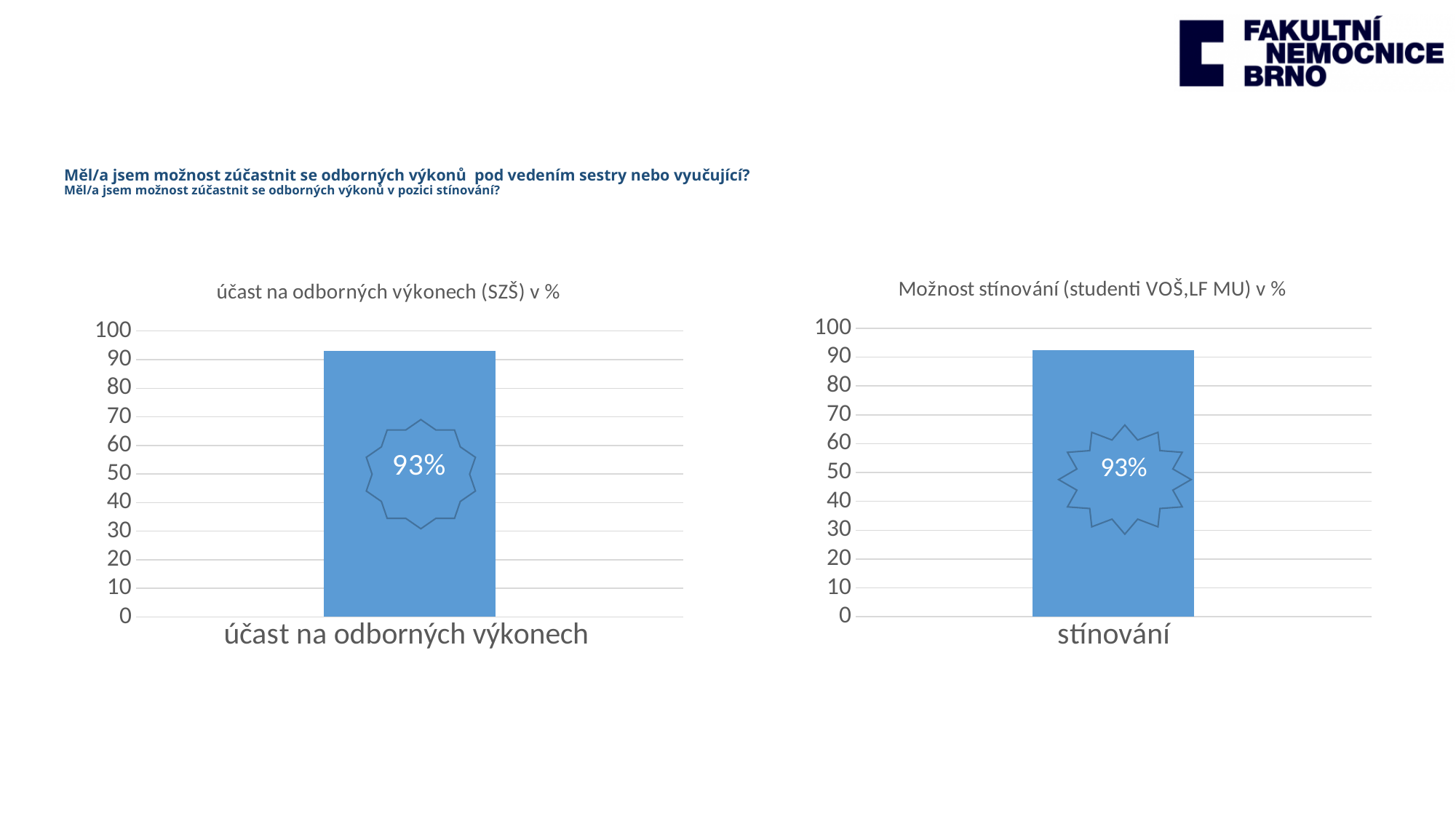
What is the difference between the value in the left chart ('účast na odborných výkonech') and the value in the right chart ('stínování')? 0 In the left chart titled 'účast na odborných výkonech (SZŠ) v %', is the value for 'účast na odborných výkonech' greater or less than 90? greater How many bars are plotted in the right chart titled 'Možnost stínování (studenti VOŠ,LF MU) v %'? 1 In the left chart titled 'účast na odborných výkonech (SZŠ) v %', what is the value for 'účast na odborných výkonech'? 93% What kind of chart is the left chart titled 'účast na odborných výkonech (SZŠ) v %'? bar chart How many bars are plotted in the left chart titled 'účast na odborných výkonech (SZŠ) v %'? 1 What kind of chart is the right chart titled 'Možnost stínování (studenti VOŠ,LF MU) v %'? bar chart In the right chart titled 'Možnost stínování (studenti VOŠ,LF MU) v %', what is the value for 'stínování'? 93% In the right chart titled 'Možnost stínování (studenti VOŠ,LF MU) v %', is the value for 'stínování' greater or less than 100? less What is the title of the left chart? účast na odborných výkonech (SZŠ) v % What is the maximum value shown on the y axis of the left chart titled 'účast na odborných výkonech (SZŠ) v %'? 100 What is the category label on the x axis of the right chart titled 'Možnost stínování (studenti VOŠ,LF MU) v %'? stínování